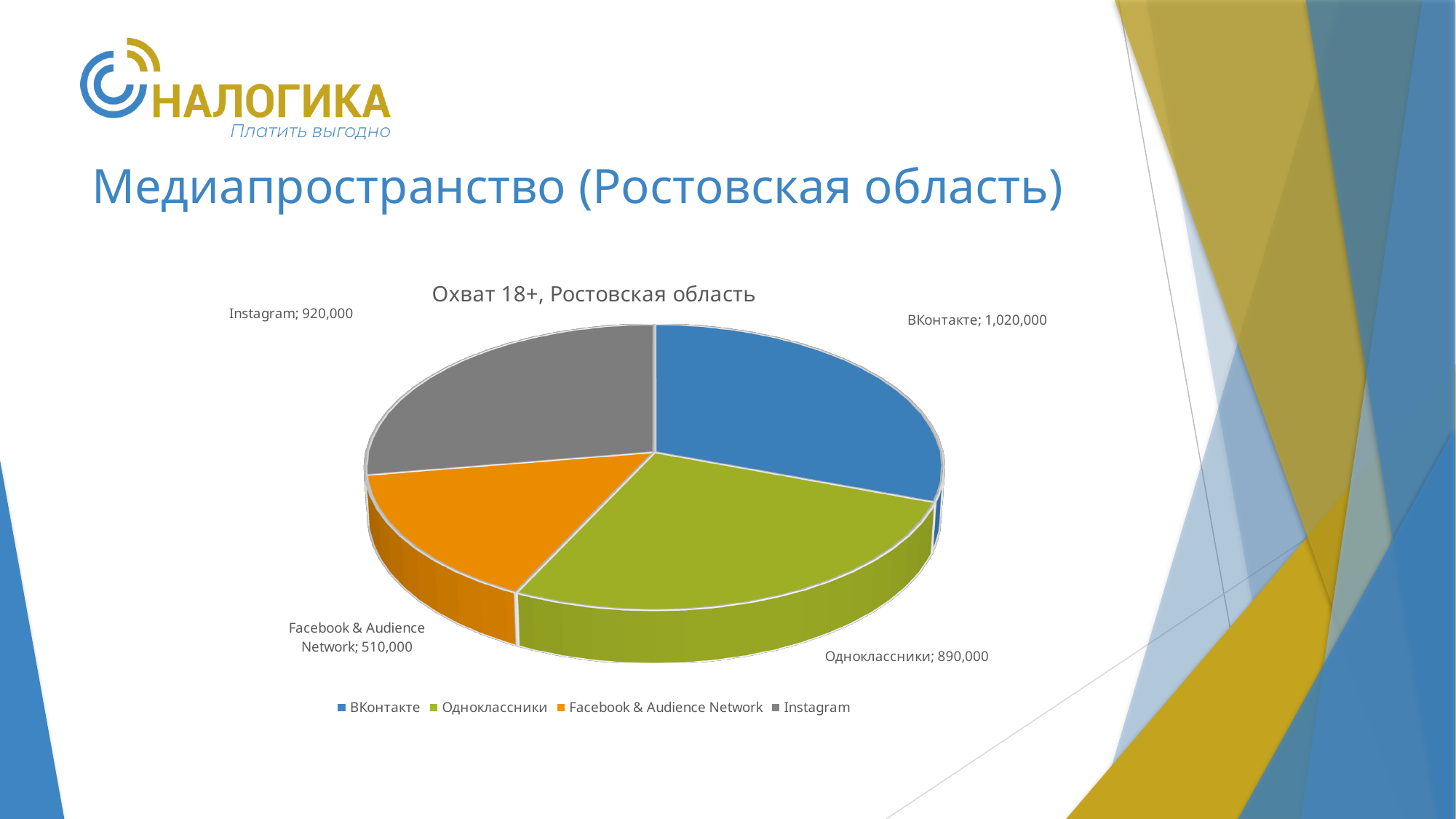
What colour is the Instagram slice? Grey What is the difference between the values for ВКонтакте and Одноклассники? 130,000 What is the value for ВКонтакте? 1,020,000 What is the value for Facebook & Audience Network? 510,000 What is the title of the chart? Охват 18+, Ростовская область Which category has the smallest slice? Facebook & Audience Network How many categories does the pie chart have? 4 Which is larger, the value for Instagram or the value for Одноклассники? Instagram What is the value for Instagram? 920,000 Which category has the largest slice? ВКонтакте What is the value for Одноклассники? 890,000 What type of chart is shown on the slide? Pie chart